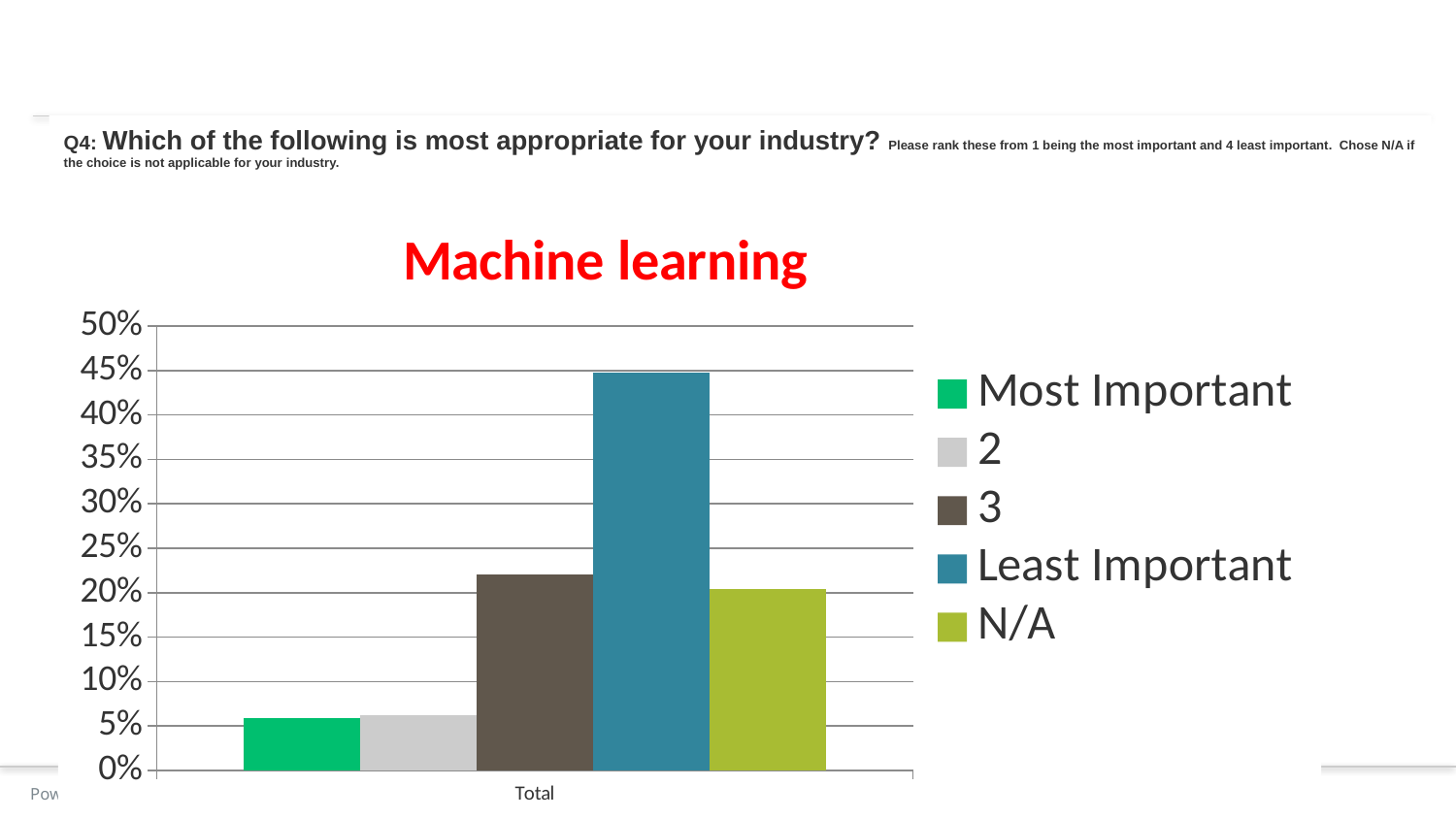
What is the title of the chart? Machine learning Is the value for 2 greater or less than 10%? less Which is larger, the value for Least Important or the value for 3? Least Important How many categories are shown on the x axis? 1 Is the value for N/A greater or less than 25%? less What is the label of the category on the x axis? Total Which series has the highest value? Least Important How many series does the legend list? 5 Is the value for Least Important greater or less than 40%? greater What type of chart is shown on the slide? bar chart Which is larger, the value for 3 or the value for Most Important? 3